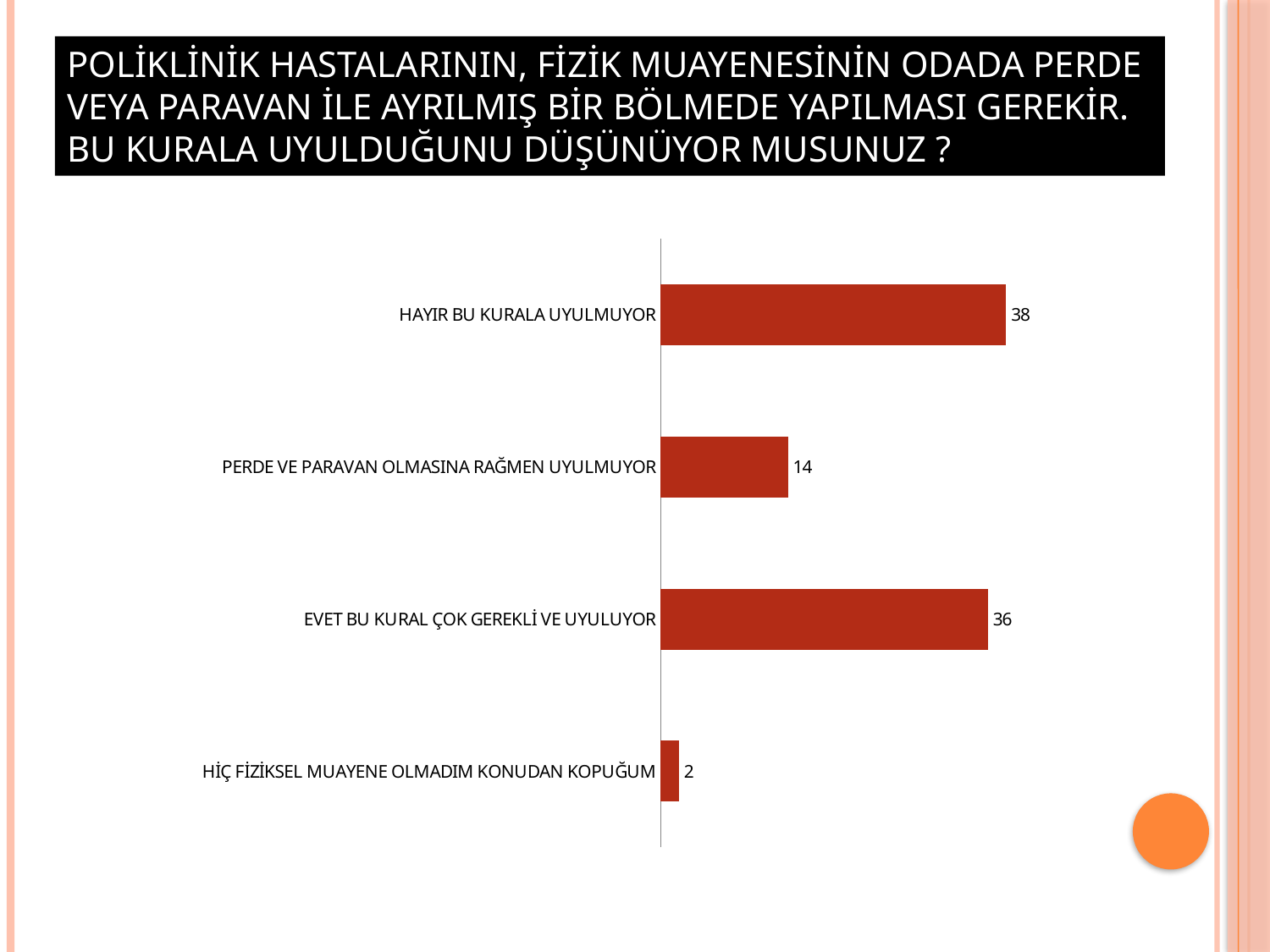
What is the value for HİÇ FİZİKSEL MUAYENE OLMADIM KONUDAN KOPUĞUM? 2 Which is larger: the value for PERDE VE PARAVAN OLMASINA RAĞMEN UYULMUYOR or the value for HİÇ FİZİKSEL MUAYENE OLMADIM KONUDAN KOPUĞUM? PERDE VE PARAVAN OLMASINA RAĞMEN UYULMUYOR Which category has the lowest value? HİÇ FİZİKSEL MUAYENE OLMADIM KONUDAN KOPUĞUM How many categories are shown in the chart? 4 What is the value for EVET BU KURAL ÇOK GEREKLİ VE UYULUYOR? 36 What kind of chart is shown on the slide? Bar chart What is the value for HAYIR BU KURALA UYULMUYOR? 38 What colour are the bars in the chart? Red What is the difference between the values for HAYIR BU KURALA UYULMUYOR and EVET BU KURAL ÇOK GEREKLİ VE UYULUYOR? 2 Which category has the highest value? HAYIR BU KURALA UYULMUYOR What is the value for PERDE VE PARAVAN OLMASINA RAĞMEN UYULMUYOR? 14 What is the difference between the values for EVET BU KURAL ÇOK GEREKLİ VE UYULUYOR and PERDE VE PARAVAN OLMASINA RAĞMEN UYULMUYOR? 22